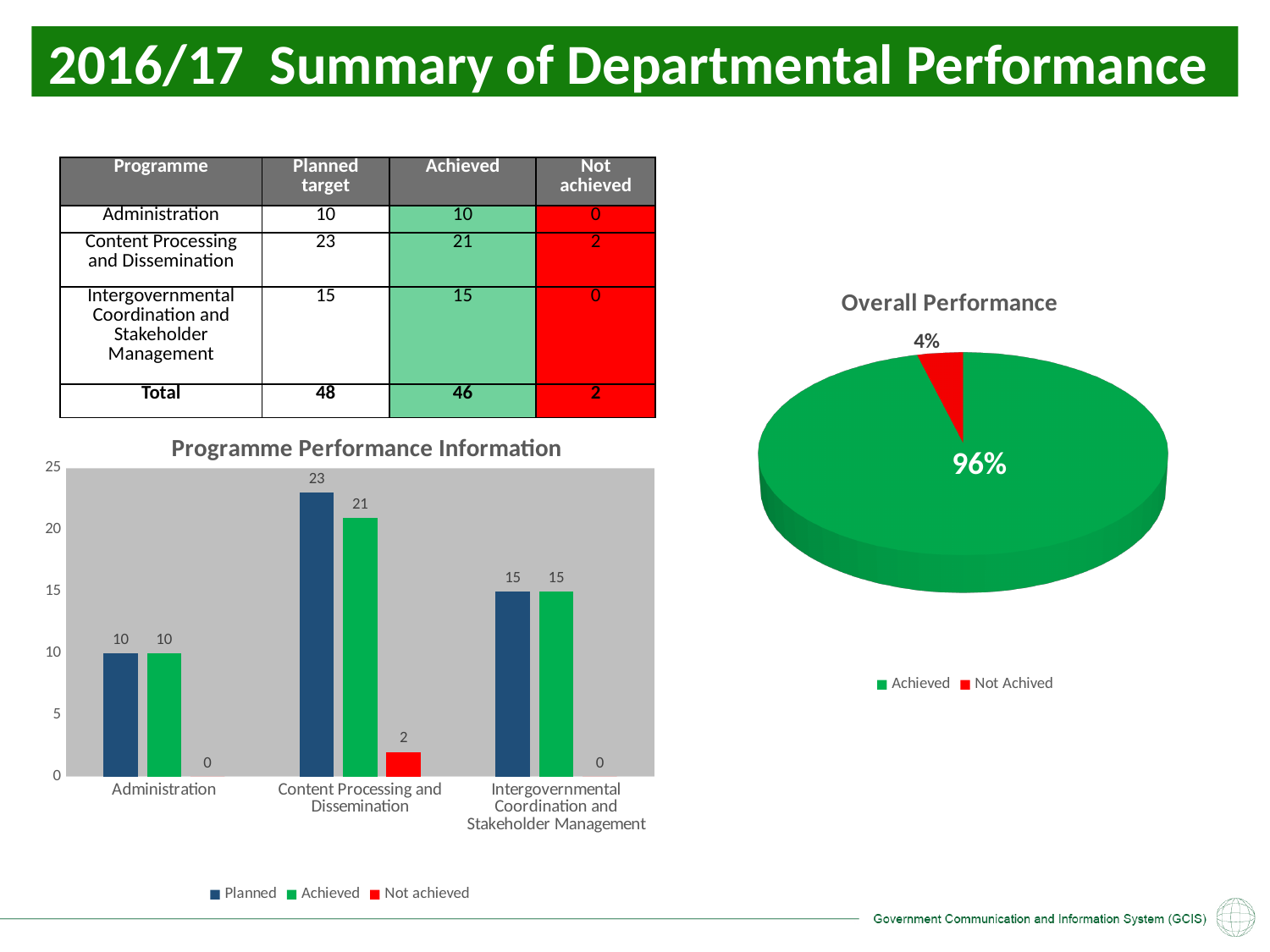
In the Programme Performance Information chart, is the Achieved value for Intergovernmental Coordination and Stakeholder Management larger or smaller than the Achieved value for Administration? larger In the Programme Performance Information chart, which programme has the highest Planned value? Content Processing and Dissemination How many series does the legend of the Programme Performance Information chart list? 3 In the Programme Performance Information chart, what is the Planned value for Content Processing and Dissemination? 23 In the Programme Performance Information chart, which programme has the lowest Achieved value? Administration In the Programme Performance Information chart, what is the Achieved value for Content Processing and Dissemination? 21 In the Programme Performance Information chart, what is the difference between the Planned and Achieved values for Content Processing and Dissemination? 2 In the Overall Performance pie chart, what share is labelled Not Achived? 4% What kind of chart is the Programme Performance Information chart? bar chart How many programmes are shown on the x axis of the Programme Performance Information chart? 3 In the Programme Performance Information chart, what is the Not achieved value for Intergovernmental Coordination and Stakeholder Management? 0 In the Overall Performance pie chart, what share is labelled Achieved? 96%